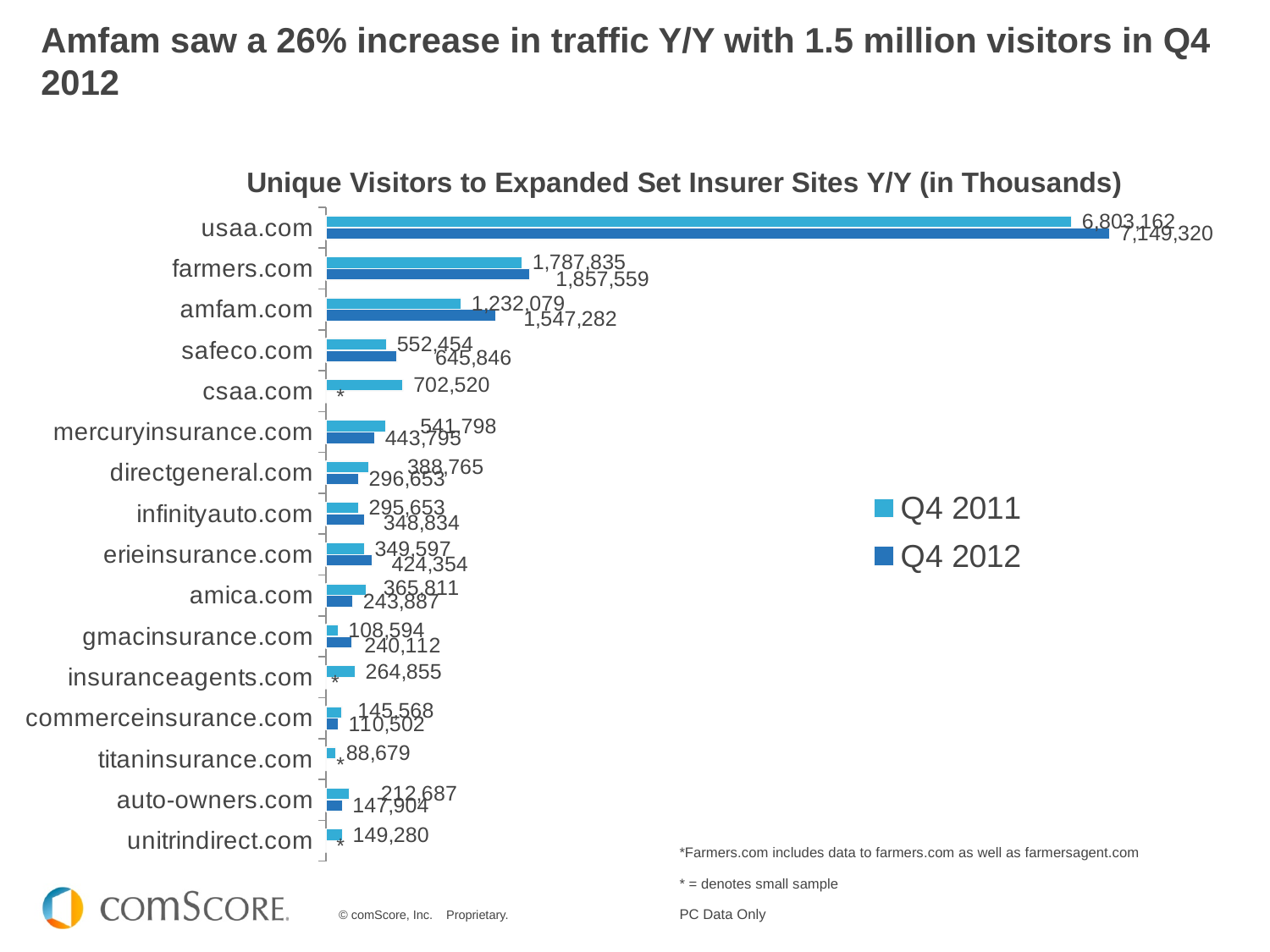
What is the difference between the Q4 2012 and Q4 2011 values for usaa.com? 346,158 What is the Q4 2011 value for csaa.com? 702,520 For gmacinsurance.com, which is larger: the Q4 2011 value or the Q4 2012 value? Q4 2012 Which site has the lowest Q4 2011 value? titaninsurance.com How many sites are listed on the chart? 16 What is the difference between the Q4 2012 and Q4 2011 values for amfam.com? 315,203 What kind of chart is shown on the slide? Bar chart How many series does the legend list? 2 What is the Q4 2012 value for usaa.com? 7,149,320 What is the Q4 2011 value for amfam.com? 1,232,079 What is the Q4 2012 value for farmers.com? 1,857,559 Which site has the highest Q4 2012 value? usaa.com